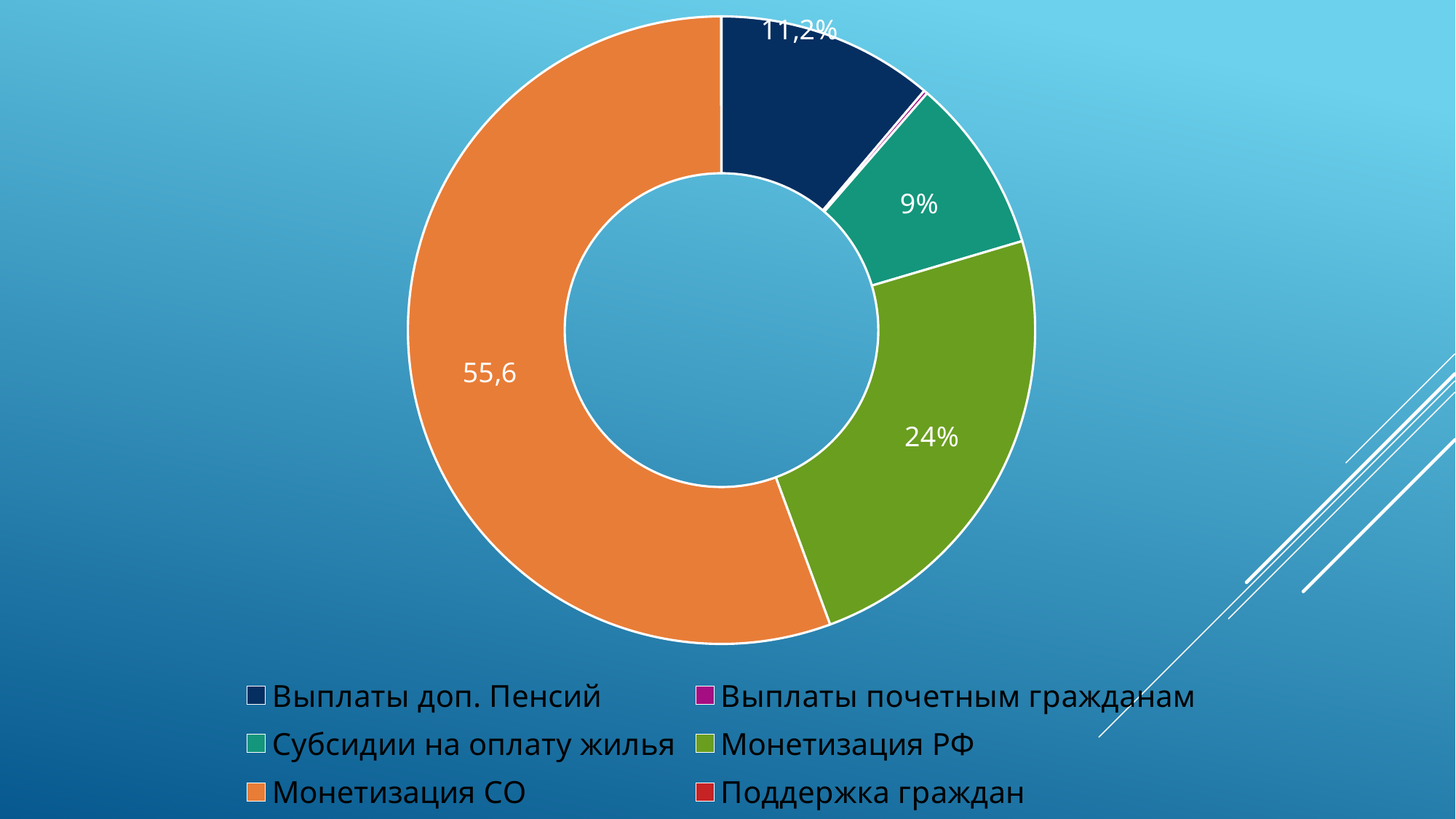
How many categories does the legend list? 6 Which is larger, the slice for Выплаты доп. Пенсий or the slice for Субсидии на оплату жилья? Выплаты доп. Пенсий What value is shown for the Монетизация СО slice? 55,6 Which category has the largest slice of the chart? Монетизация СО Which legend entry is shown in dark navy blue? Выплаты доп. Пенсий What kind of chart is shown on the slide? Doughnut (pie) chart Which is larger, the slice for Монетизация РФ or the slice for Субсидии на оплату жилья? Монетизация РФ What percentage is shown for Субсидии на оплату жилья? 9% What colour is the Монетизация СО slice? Orange What is the difference between the Монетизация РФ value and the Субсидии на оплату жилья value? 15% What percentage is shown for Монетизация РФ? 24% What percentage is shown for Выплаты доп. Пенсий? 11,2%